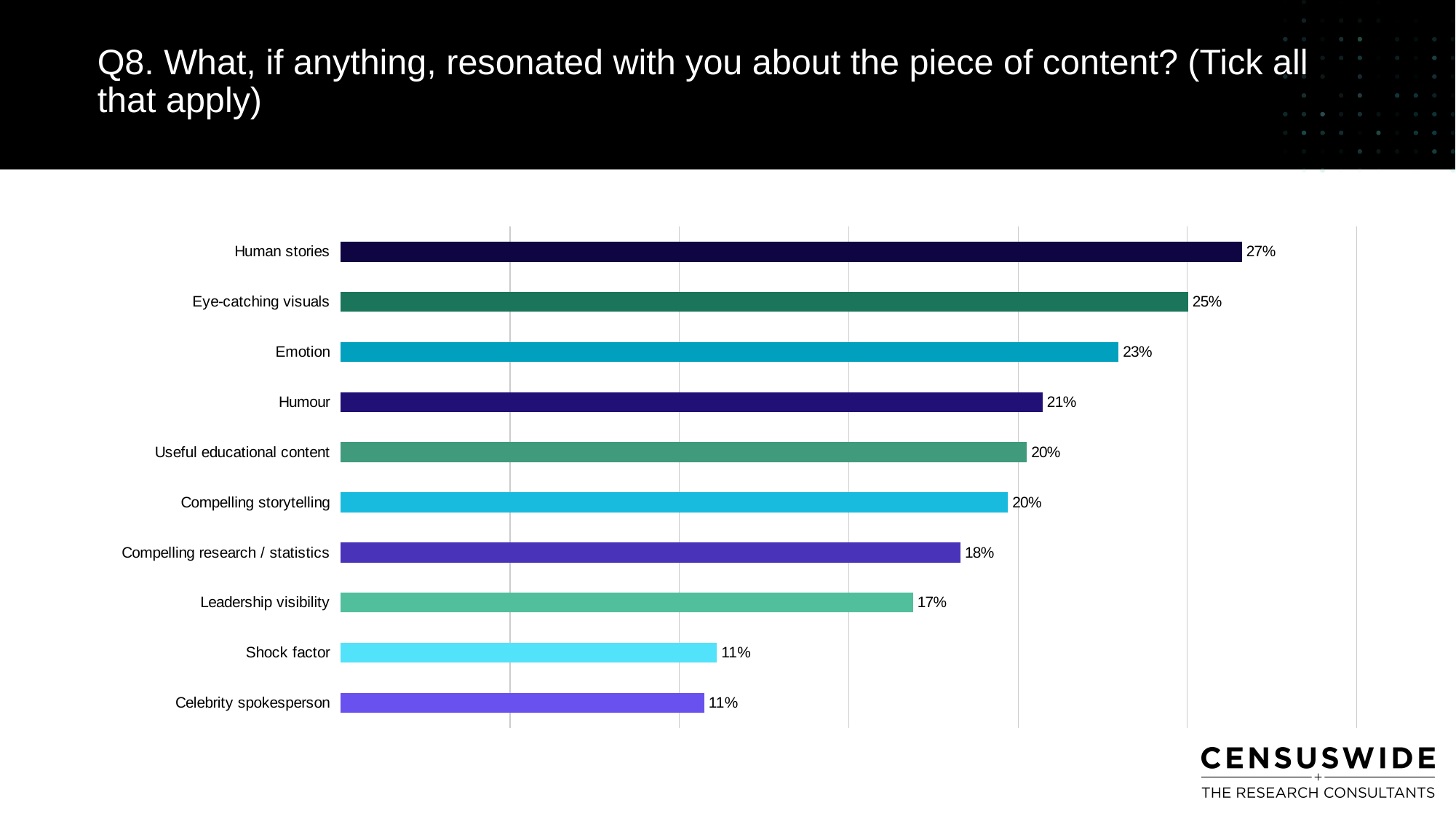
Which category has the highest value? Human stories Which is larger, the value for Humour or the value for Leadership visibility? Humour How many categories are shown in the chart? 10 What is the difference between the values for Human stories and Eye-catching visuals? 2% What is the value shown for Compelling research / statistics? 18% Which is larger, the value for Emotion or the value for Useful educational content? Emotion Which two categories both have a value of 20%? Useful educational content and Compelling storytelling Which two categories share the lowest value of 11%? Shock factor and Celebrity spokesperson What is the value shown for Leadership visibility? 17% What percentage of respondents said human stories resonated with them? 27% What is the difference between the values for Emotion and Shock factor? 12% What kind of chart is shown on the slide? Bar chart